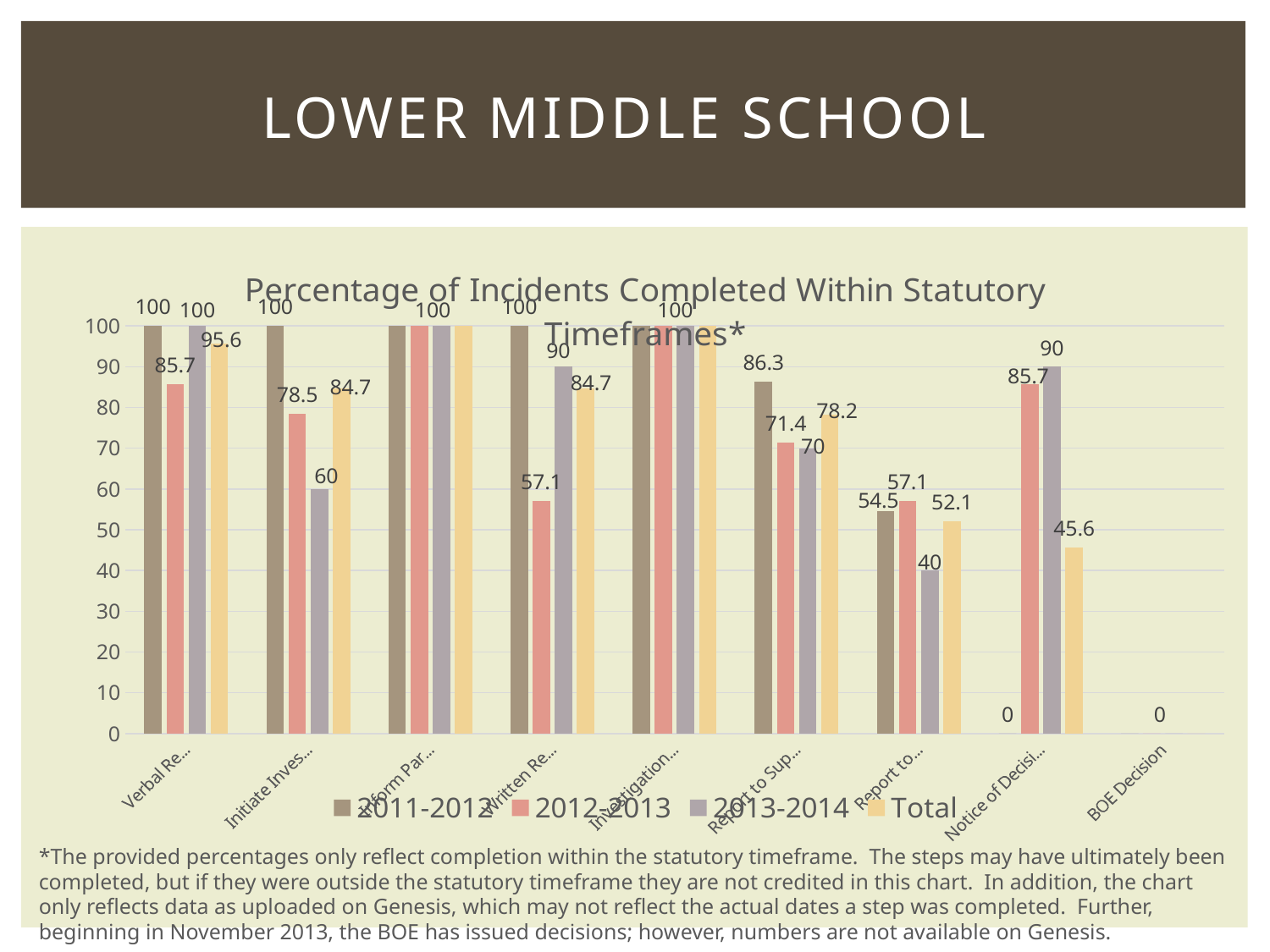
What kind of chart is shown on the slide? Bar chart For the eighth category (Notice of Decisi...), what is the difference between the 2013-2014 value and the 2012-2013 value? 4.3 What value is shown for the BOE Decision category? 0 What is the 2013-2014 value for the fourth category (Written Re...)? 90 For the sixth category (Report to Sup...), what is the difference between the 2011-2012 value and the 2012-2013 value? 14.9 Which category has the lowest 2013-2014 value among those with a 2013-2014 bar? Report to... (seventh category) What is the title of the chart? Percentage of Incidents Completed Within Statutory Timeframes* For the second category (Initiate Inves...), which is larger: the 2012-2013 value or the 2013-2014 value? 2012-2013 What is the 2012-2013 value for the first category (Verbal Re...)? 85.7 How many series does the chart legend list? 4 How many categories are shown along the x axis of the chart? 9 What is the Total value for the eighth category (Notice of Decisi...)? 45.6